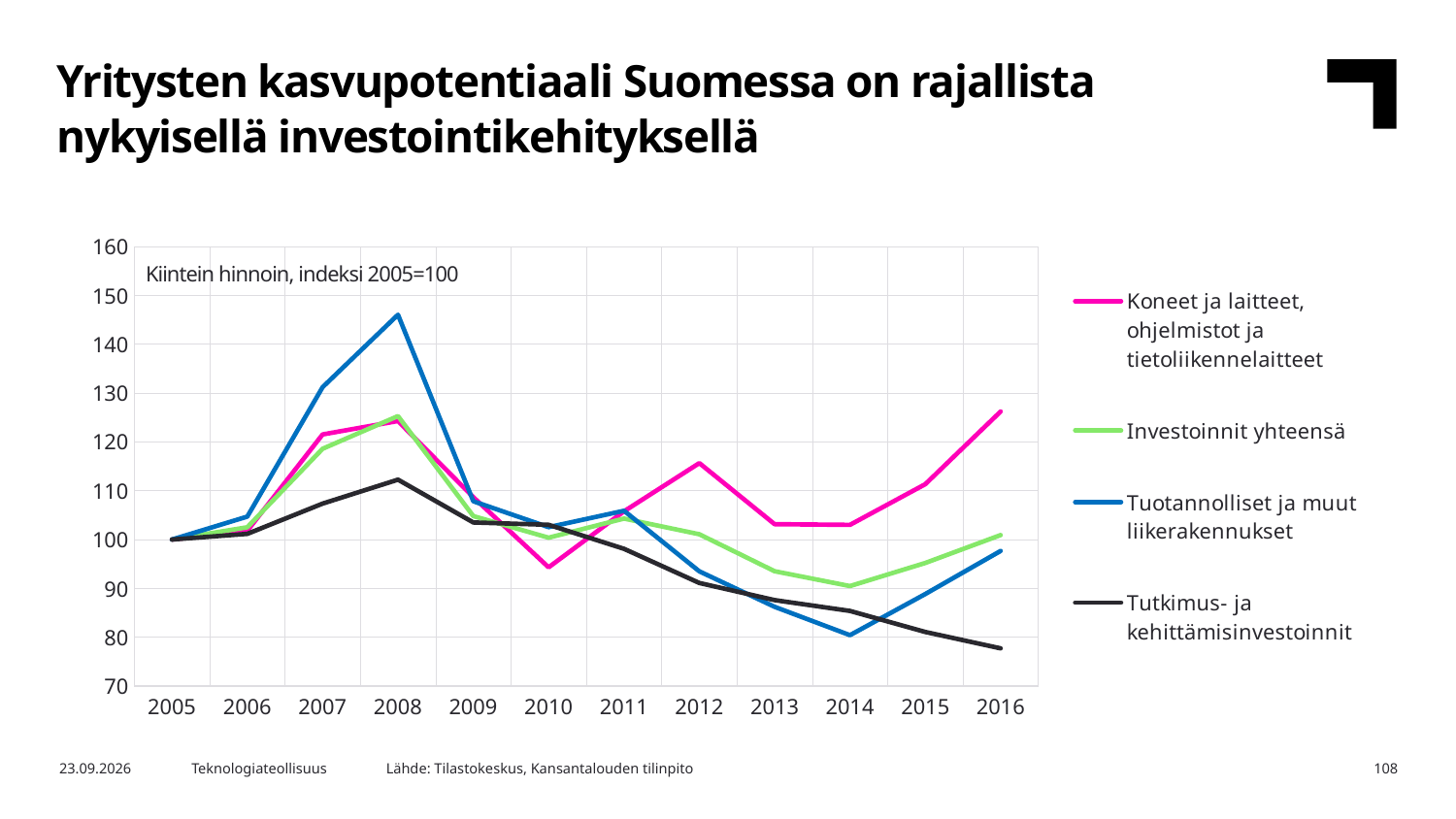
Which series has the lowest value in 2016? Tutkimus- ja kehittämisinvestoinnit Does Tutkimus- ja kehittämisinvestoinnit rise or fall from 2008 to 2016? fall Is the value for Tutkimus- ja kehittämisinvestoinnit in 2016 greater or less than 80? less How many series does the legend list? 4 What is the index value of Investoinnit yhteensä in 2005? 100 Is the value for Tuotannolliset ja muut liikerakennukset in 2008 greater or less than 140? greater What kind of chart is shown on the slide? line chart Is the value for Koneet ja laitteet, ohjelmistot ja tietoliikennelaitteet in 2010 greater or less than 100? less In 2012, which is larger: Koneet ja laitteet, ohjelmistot ja tietoliikennelaitteet or Investoinnit yhteensä? Koneet ja laitteet, ohjelmistot ja tietoliikennelaitteet How many years are shown on the x axis? 12 Which series has the highest value in 2008? Tuotannolliset ja muut liikerakennukset In which year does Tuotannolliset ja muut liikerakennukset reach its peak? 2008